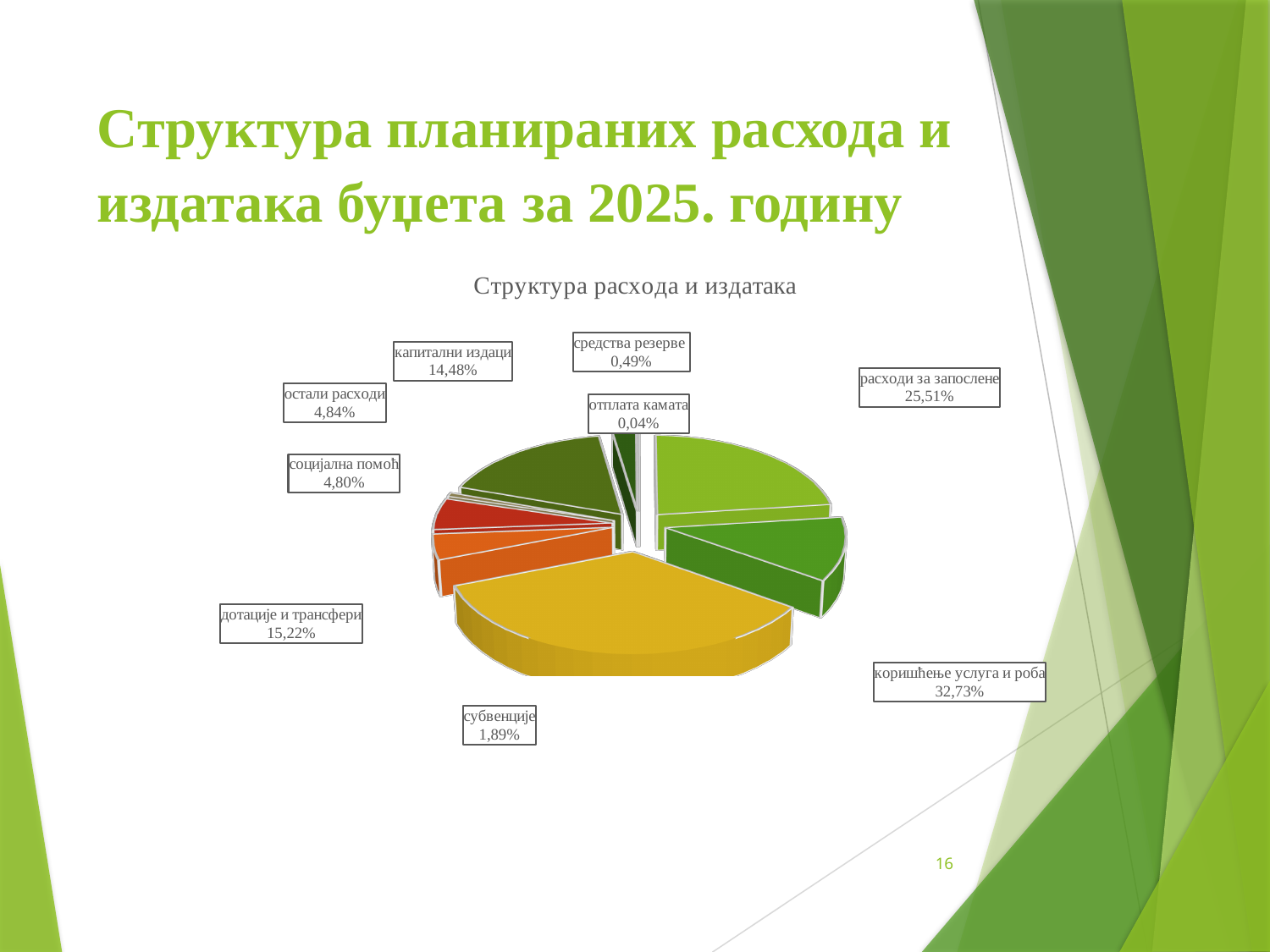
What is the title of the chart? Структура расхода и издатака What is the difference between коришћење услуга и роба and расходи за запослене? 7,22% How many categories are shown in the pie chart? 9 What is the value for дотације и трансфери? 15,22% What is the value for субвенције? 1,89% What is the value for капитални издаци? 14,48% Which category has the smallest share of the pie? отплата камата What type of chart is shown on the slide? pie chart What share of the pie is коришћење услуга и роба? 32,73% What is the value for расходи за запослене? 25,51% Which is larger, дотације и трансфери or капитални издаци? дотације и трансфери